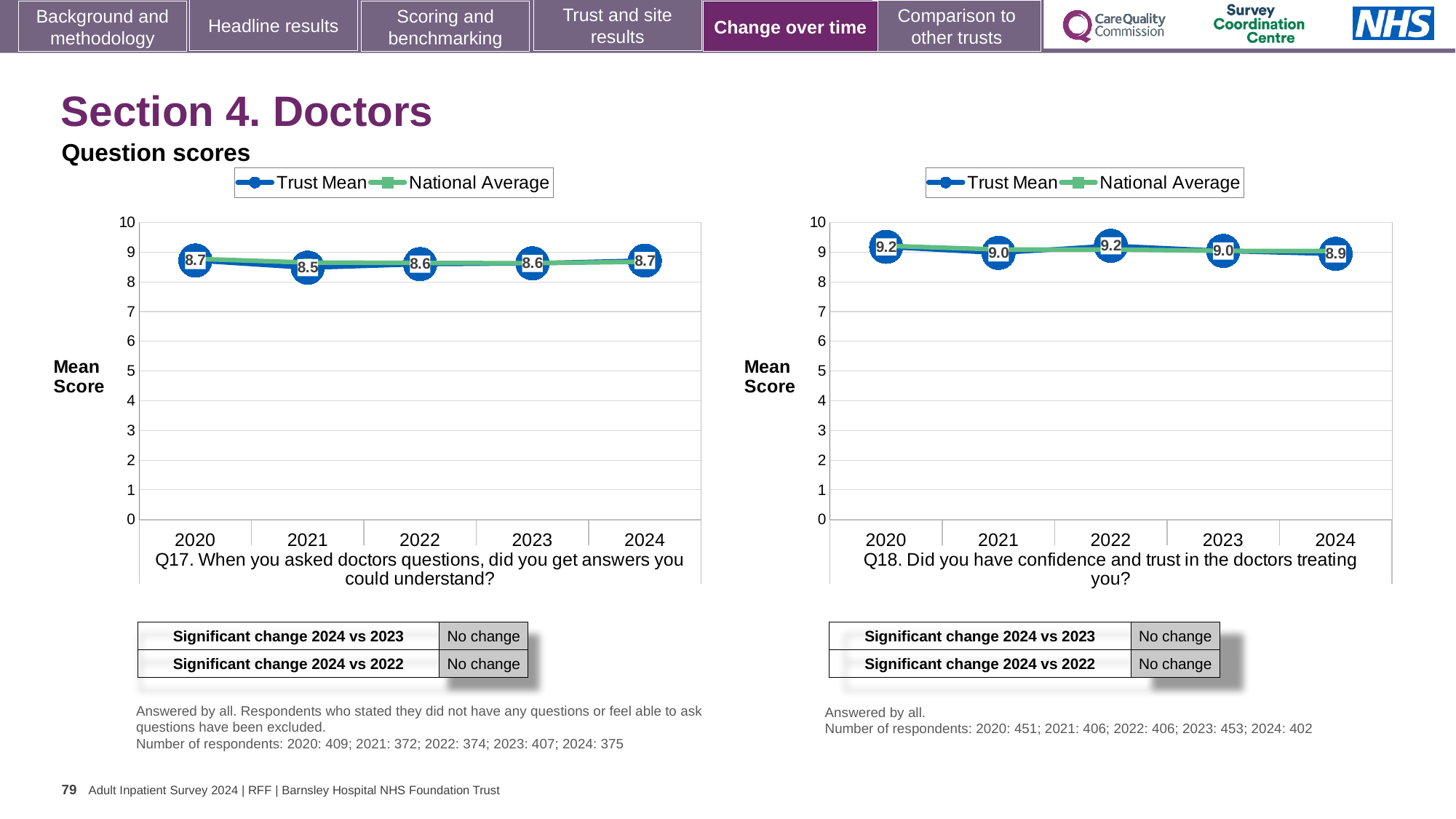
On the Q18 chart, what is the Trust Mean score for 2022? 9.2 How many series does the legend of the Q18 chart list? 2 On the Q17 chart, what is the Trust Mean score for 2020? 8.7 On the Q18 chart, what is the Trust Mean score for 2024? 8.9 What type of chart is used for Q17? Line chart On the Q18 chart, which year has the lowest Trust Mean score? 2024 On the Q17 chart, which year has the lowest Trust Mean score? 2021 On the Q17 chart, what is the Trust Mean score for 2021? 8.5 On the Q17 chart, what is the difference between the Trust Mean scores for 2024 and 2021? 0.2 Is the Trust Mean score for 2022 on the Q18 chart larger than the Trust Mean score for 2022 on the Q17 chart? Yes On the Q18 chart, what is the difference between the Trust Mean scores for 2020 and 2024? 0.3 How many years are plotted on the Q17 chart? 5